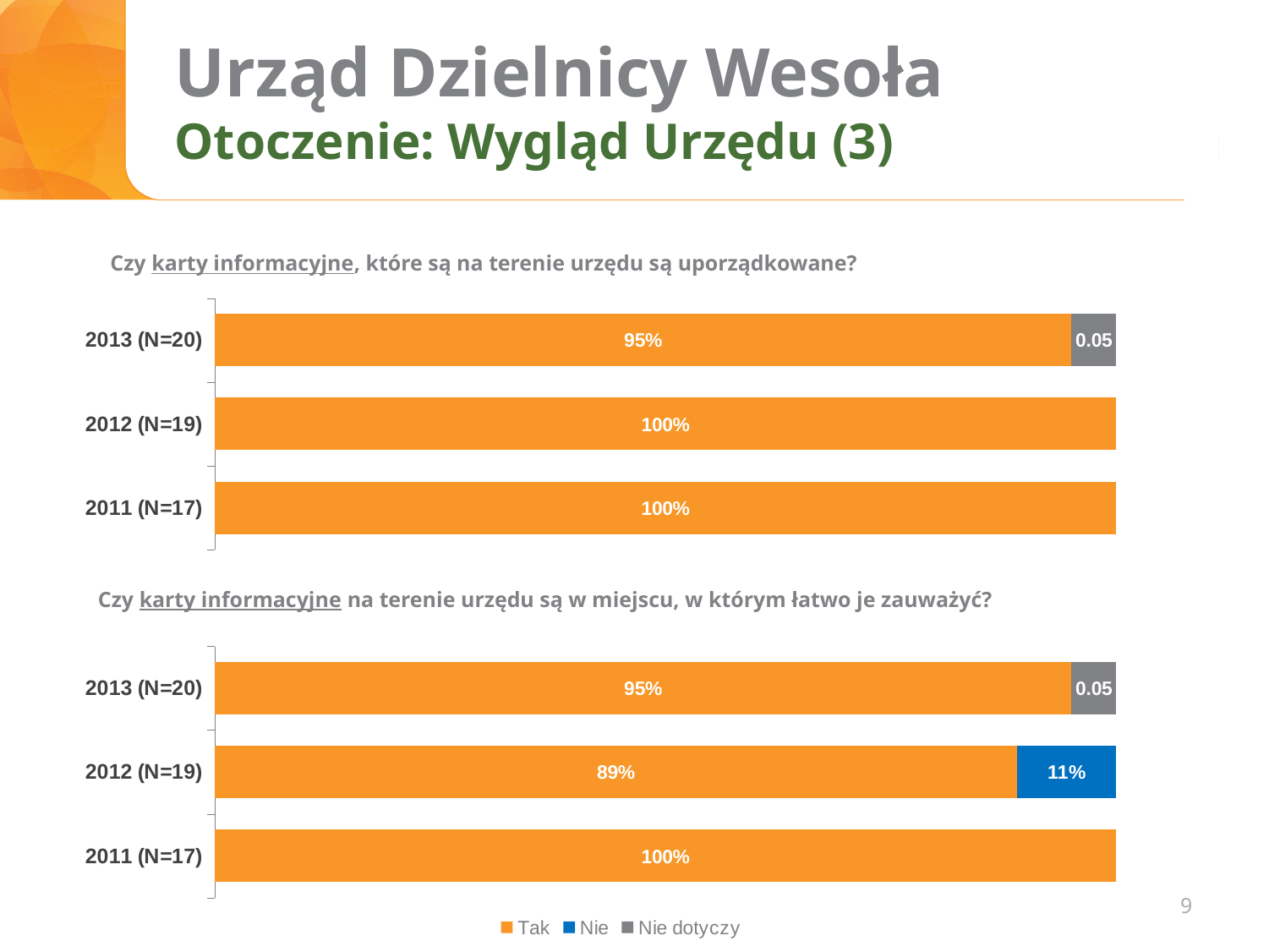
In the bottom chart, what is the 'Nie' value for 2012 (N=19)? 11% In the top chart, which is larger: the 'Tak' value for 2013 (N=20) or for 2011 (N=17)? 2011 (N=17) Which series is shown in blue in the legend? Nie In the top chart, what is the 'Tak' value for 2012 (N=19)? 100% What type of chart is the top chart? Bar chart In the bottom chart, what label is shown on the grey 'Nie dotyczy' segment for 2013 (N=20)? 0.05 In the bottom chart, what is the difference between the 'Tak' values for 2011 (N=17) and 2012 (N=19)? 11% In the bottom chart, which year has the lowest 'Tak' value? 2012 (N=19) How many year categories does the bottom chart show? 3 In the top chart, what is the 'Tak' value for 2013 (N=20)? 95% In the bottom chart, what is the 'Tak' value for 2012 (N=19)? 89% How many series does the legend at the bottom of the slide list? 3